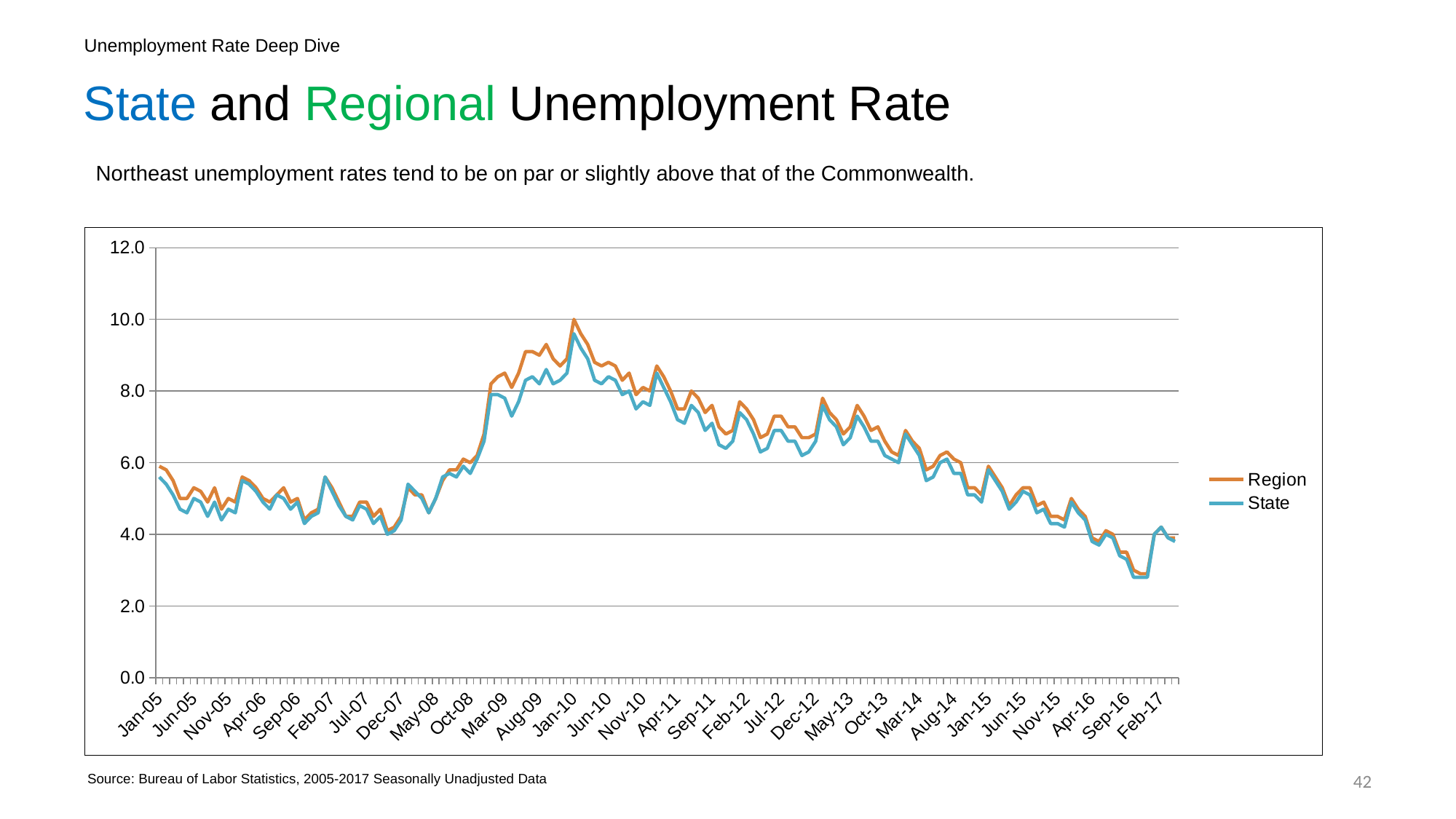
Is the value for Region at Jan-10 greater or less than 8.0? greater Is the value for Region at Jun-15 greater or less than 6.0? less Do the values for Region rise or fall between Dec-07 and Jan-10? rise Is the value for Region at Sep-16 greater or less than 4.0? less What kind of chart is shown on the slide? Line chart How many series does the legend list? 2 Which series is drawn in blue? State Which series is drawn in orange? Region Do the values for State rise or fall between Jan-10 and Sep-16? fall Which series reaches the highest value on the chart? Region